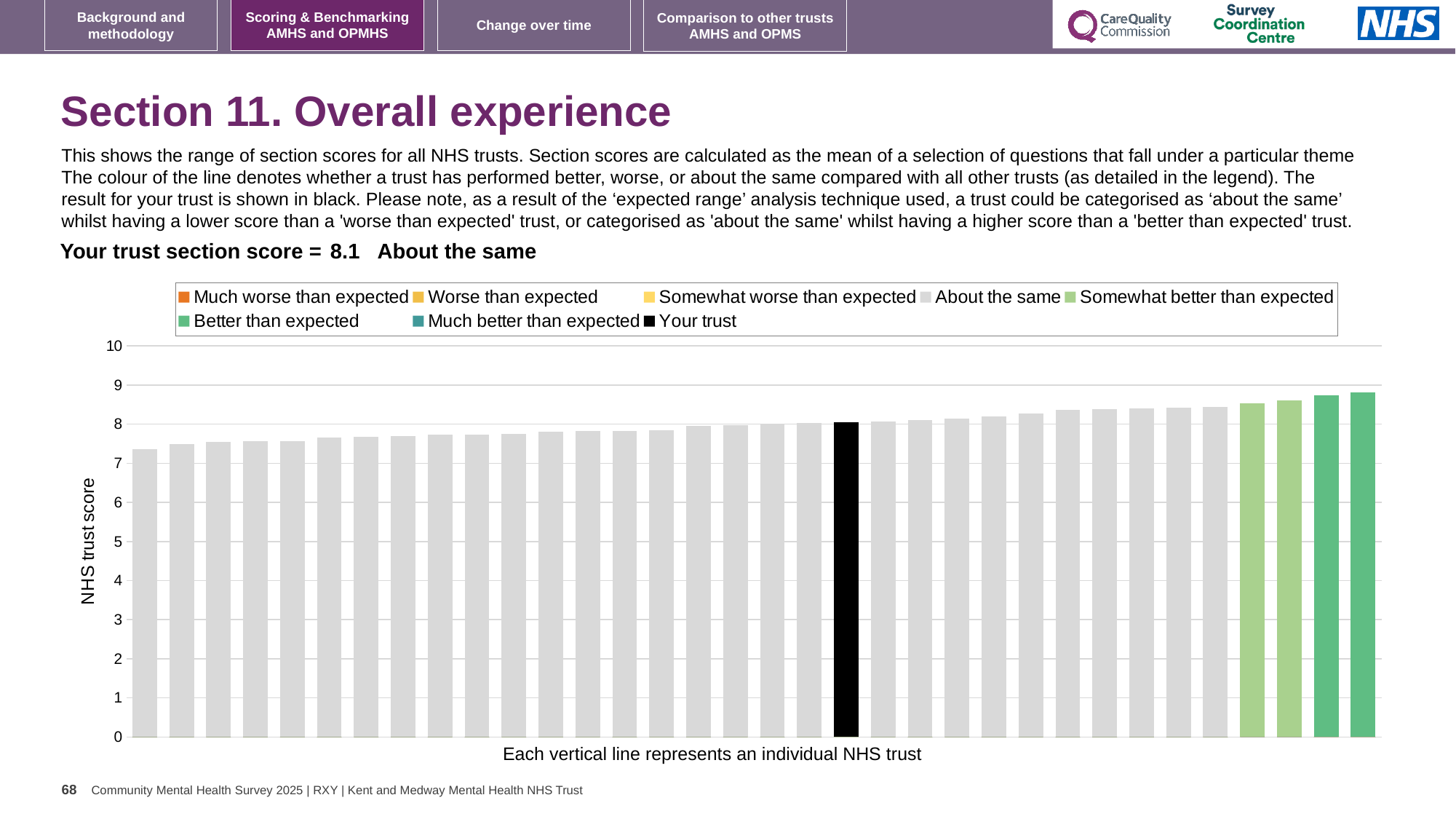
Is the value of the leftmost bar greater or less than 7? greater Do the bar values rise or fall from left to right across the chart? rise Is the value of the leftmost bar greater or less than 8? less What kind of chart is shown on the slide? bar chart What is the label on the vertical axis of the chart? NHS trust score Which category is your trust's section score placed in? About the same What is the section score for your trust shown on the slide? 8.1 Is the value of the rightmost bar greater or less than 8? greater How many entries does the chart legend list? 8 Which bar is larger, the leftmost bar or the rightmost bar? the rightmost bar How many bars are coloured as 'Better than expected' (the darker green)? 2 What colour is the bar representing your trust? black